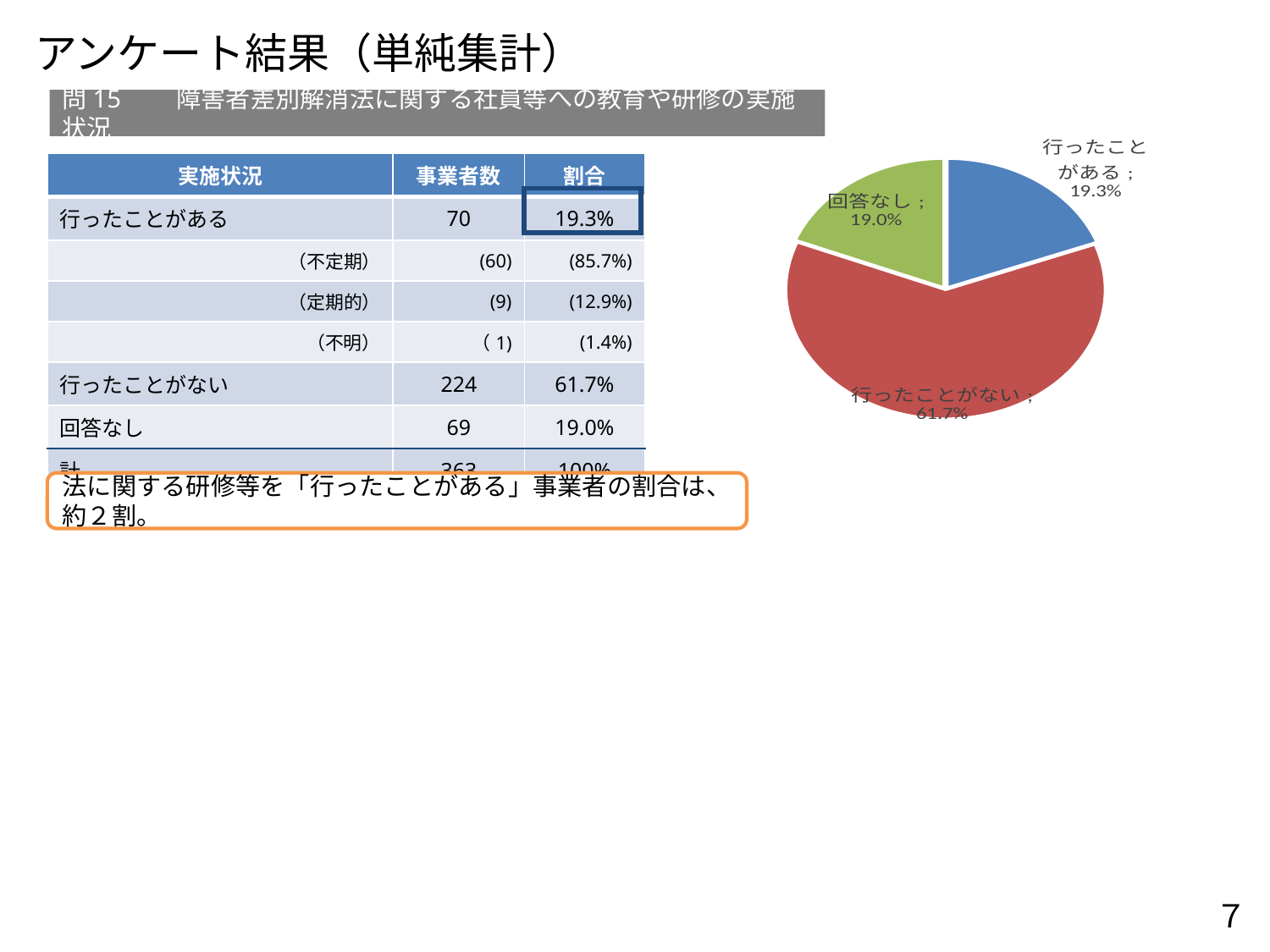
Which category has the largest slice in the pie chart? 行ったことがない How many slices does the pie chart have? 3 What colour is the slice for 回答なし in the pie chart? green What percentage is shown for 行ったことがある in the pie chart? 19.3% What is the difference in percentage points between 行ったことがない and 回答なし in the pie chart? 42.7 What is the difference in percentage points between 行ったことがない and 行ったことがある in the pie chart? 42.4 Is the slice for 行ったことがない larger or smaller than the slice for 行ったことがある? larger What percentage is shown for 回答なし in the pie chart? 19.0% What type of chart is shown on the slide? pie chart What share of the pie chart does 行ったことがない represent? 61.7% Is the slice for 回答なし larger or smaller than the slice for 行ったことがない? smaller What colour is the slice for 行ったことがない in the pie chart? red